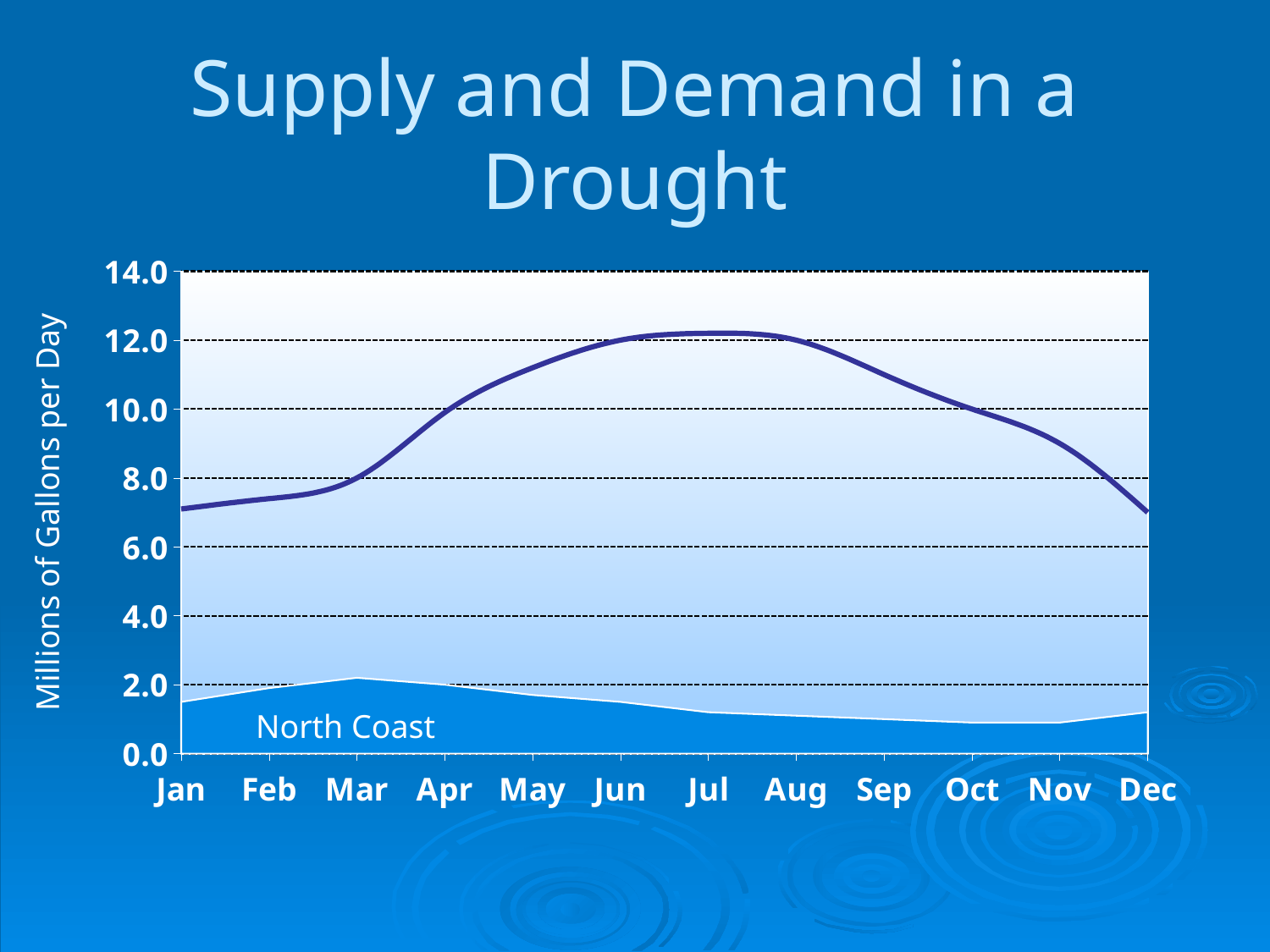
Is the value of the dark blue line in Jul greater or less than 10.0? greater In which month does the dark blue line reach its highest value? Jul Does the dark blue line rise or fall from Jan to Jul? rise Is the value of the North Coast area in Jul greater or less than 2.0? less Is the value of the dark blue line in Sep greater or less than 10.0? greater How many months are shown along the x axis of the chart? 12 What is the label on the vertical axis of the chart? Millions of Gallons per Day What is the title of the slide containing the chart? Supply and Demand in a Drought In which month does the shaded North Coast area reach its highest value? Mar Which is larger, the dark blue line's value in Jul or in Jan? Jul Does the dark blue line rise or fall from Jul to Dec? fall